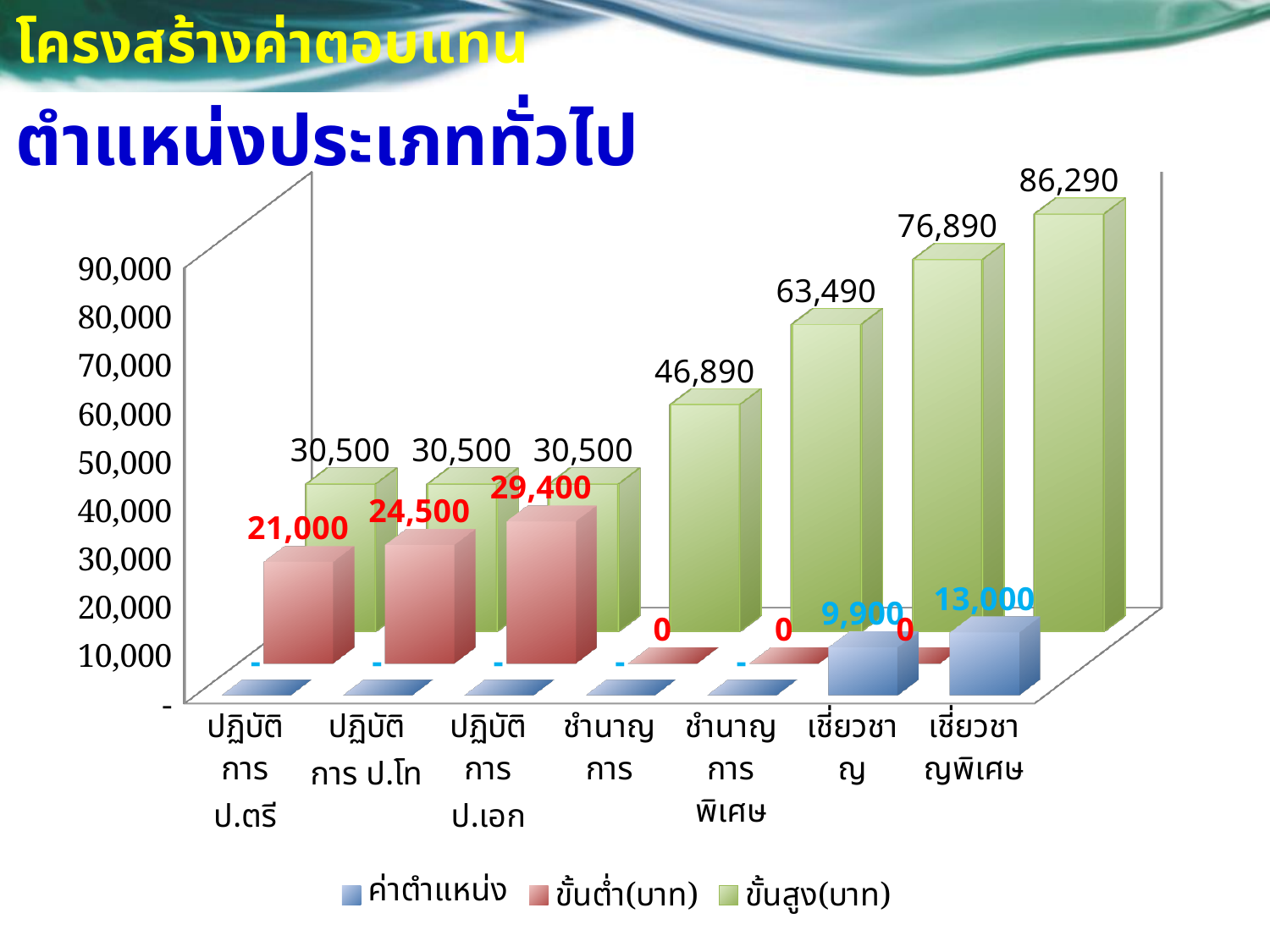
How many categories are shown on the x axis? 7 Which category has the highest ขั้นสูง(บาท) value? เชี่ยวชาญพิเศษ Which category has the highest ขั้นต่ำ(บาท) value? ปฏิบัติการ ป.เอก What is the ขั้นสูง(บาท) value for ชำนาญการพิเศษ? 63,490 What is the difference between the ค่าตำแหน่ง values for เชี่ยวชาญพิเศษ and เชี่ยวชาญ? 3,100 What is the ขั้นสูง(บาท) value for เชี่ยวชาญพิเศษ? 86,290 Which is larger, the ขั้นสูง(บาท) value for ชำนาญการ or for ชำนาญการพิเศษ? ชำนาญการพิเศษ Does the ขั้นสูง(บาท) series rise or fall from ชำนาญการ to เชี่ยวชาญพิเศษ? rise What is the ขั้นต่ำ(บาท) value for ปฏิบัติการ ป.โท? 24,500 How many series does the legend list? 3 What is the ค่าตำแหน่ง value for เชี่ยวชาญ? 9,900 What is the difference between the ขั้นสูง(บาท) values for เชี่ยวชาญพิเศษ and เชี่ยวชาญ? 9,400